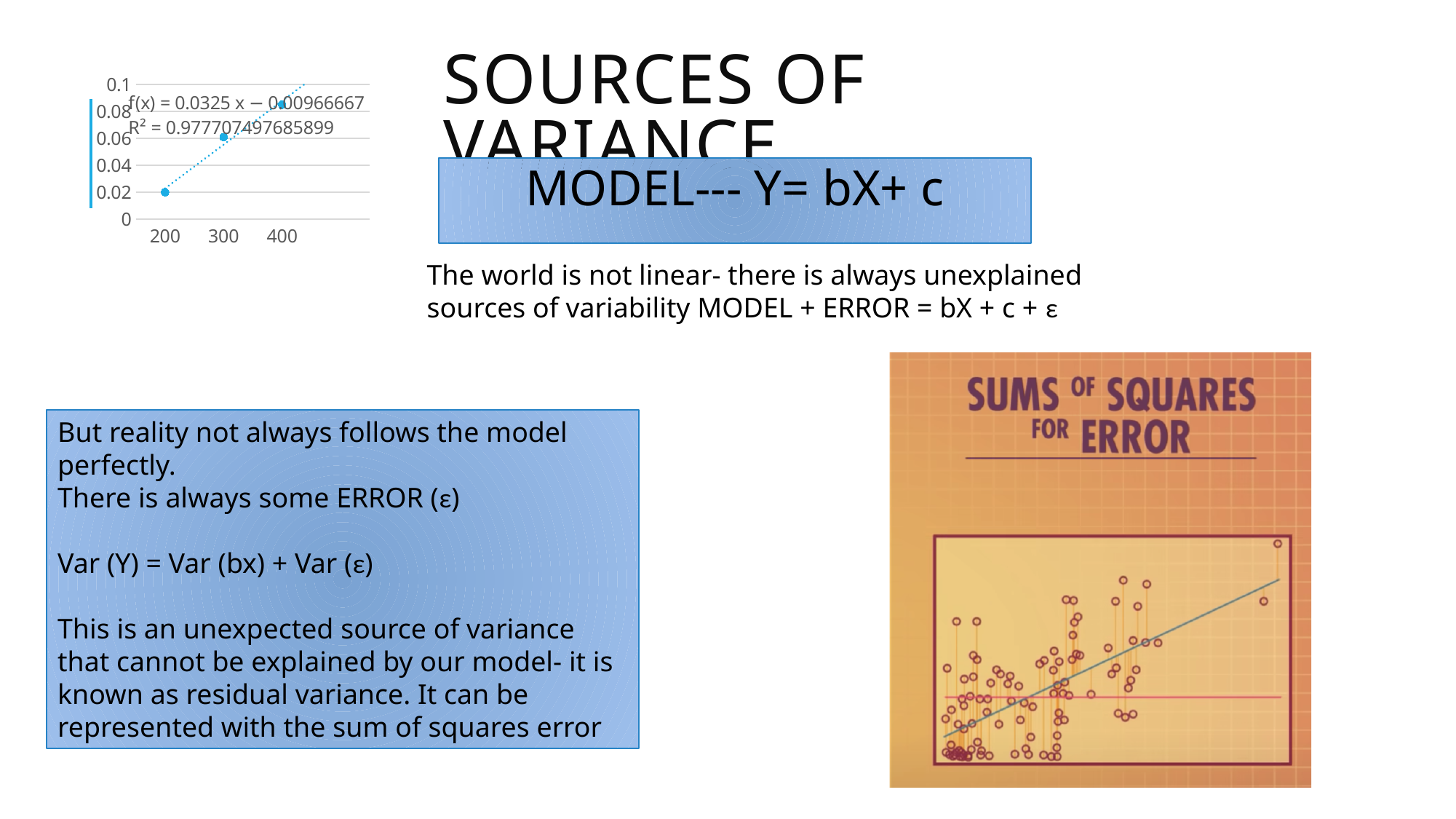
In the top-left chart, is the value at x = 400 greater or less than 0.1? less How many data points are plotted in the top-left chart? 3 In the top-left chart, at which x value is the highest point plotted? 400 In the top-left chart, what is the y value of the point at x = 200? 0.02 What trendline equation is printed on the top-left chart? f(x) = 0.0325 x − 0.00966667 What R² value is printed on the top-left chart? R² = 0.977707497685899 In the top-left chart, which point has the larger y value, the one at x = 200 or the one at x = 300? x = 300 In the top-left chart, is the value at x = 300 greater or less than 0.04? greater In the top-left chart, do the values rise or fall as x increases from 200 to 400? rise What kind of chart is shown at the top left of the slide? scatter chart In the top-left chart, at which x value is the lowest point plotted? 200